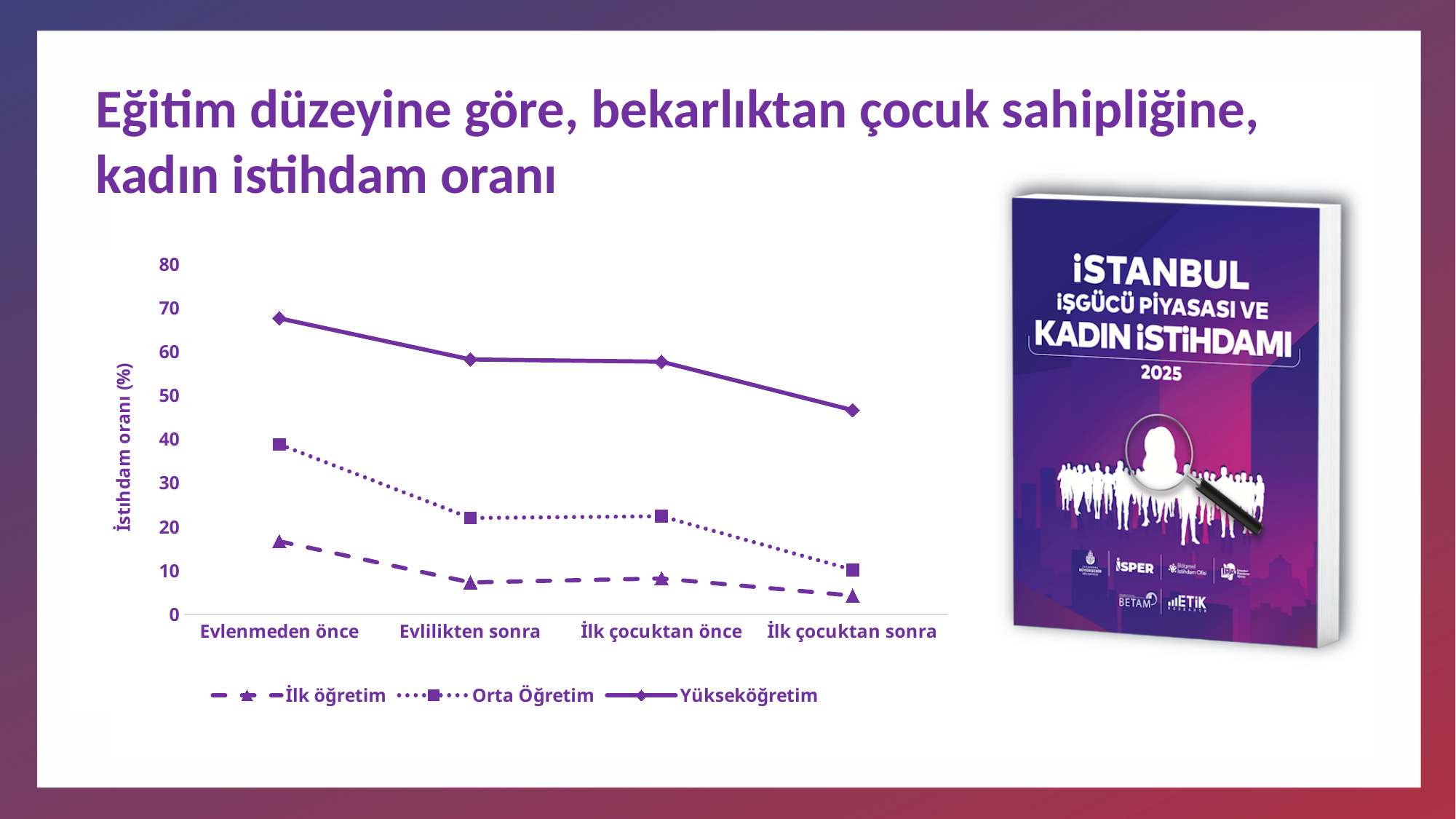
Is the value for İlk öğretim at İlk çocuktan sonra greater or less than 10? less Is the value for Orta Öğretim at Evlenmeden önce greater or less than 30? greater Is the value for Yükseköğretim at İlk çocuktan sonra greater or less than 50? less At which category is the Orta Öğretim series lowest? İlk çocuktan sonra What kind of chart is shown on the slide? Line chart How many categories are shown along the x axis? 4 Does the Yükseköğretim series rise or fall from Evlenmeden önce to İlk çocuktan sonra? Fall At which category is the Yükseköğretim series highest? Evlenmeden önce How many series does the legend list? 3 Which series has the highest value at Evlilikten sonra? Yükseköğretim